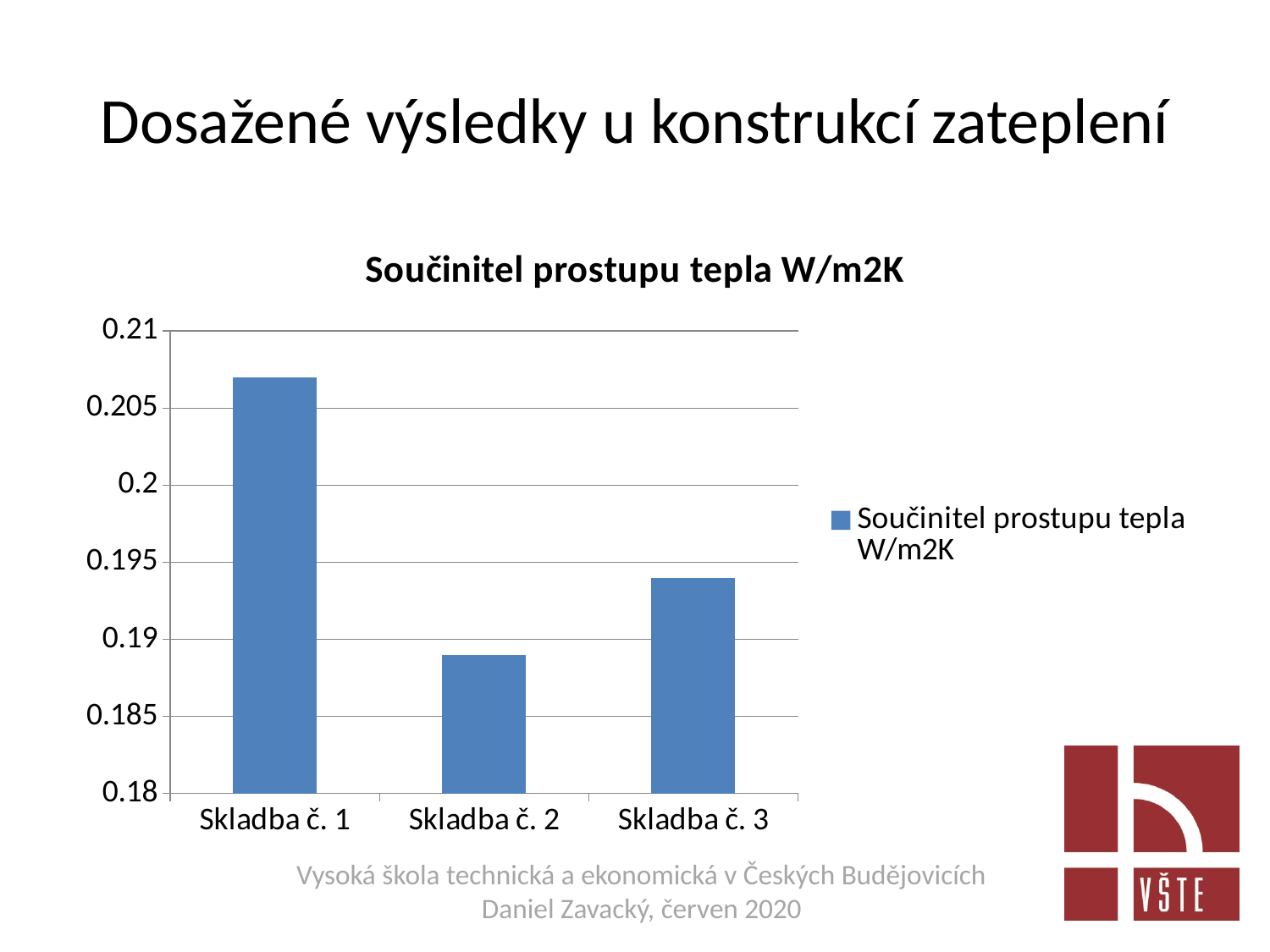
Is the value for Skladba č. 2 greater or less than 0.195? less Which category has the lowest value in the chart? Skladba č. 2 Is the value for Skladba č. 3 greater or less than 0.19? greater Which has a larger value, Skladba č. 1 or Skladba č. 3? Skladba č. 1 What kind of chart is shown on the slide? bar chart What is the legend entry shown to the right of the chart? Součinitel prostupu tepla W/m2K Which category has the highest value in the chart? Skladba č. 1 Is the value for Skladba č. 1 greater or less than 0.205? greater How many series does the chart's legend list? 1 What is the title of the chart? Součinitel prostupu tepla W/m2K How many categories are plotted on the x axis of the chart? 3 Which has a larger value, Skladba č. 2 or Skladba č. 3? Skladba č. 3